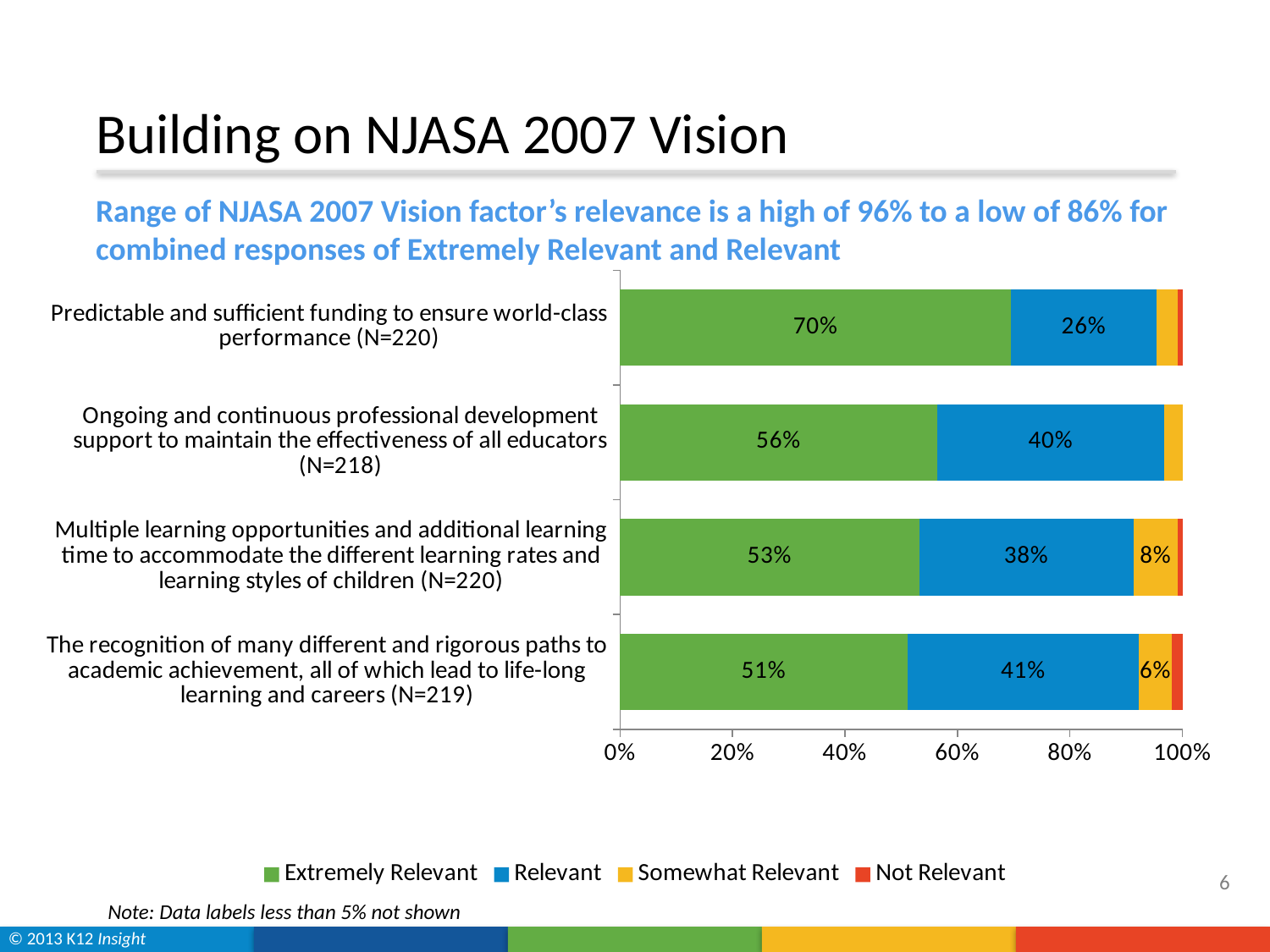
How many series does the legend list? 4 How many factors (categories) are shown in the chart? 4 For "Multiple learning opportunities and additional learning time", which is larger: the Extremely Relevant share or the Relevant share? Extremely Relevant What percentage of respondents rated "Predictable and sufficient funding to ensure world-class performance" as Extremely Relevant? 70% What is the Somewhat Relevant percentage for "Multiple learning opportunities and additional learning time to accommodate the different learning rates and learning styles of children"? 8% What is the combined Extremely Relevant and Relevant percentage for "Predictable and sufficient funding to ensure world-class performance"? 96% Which factor has the lowest Relevant percentage? Predictable and sufficient funding to ensure world-class performance What is the difference between the Extremely Relevant percentages for "Predictable and sufficient funding" and "Ongoing and continuous professional development support"? 14 percentage points What is the Somewhat Relevant percentage for "The recognition of many different and rigorous paths to academic achievement, all of which lead to life-long learning and careers"? 6% Which factor has the highest Extremely Relevant percentage? Predictable and sufficient funding to ensure world-class performance What is the Relevant percentage for "Ongoing and continuous professional development support to maintain the effectiveness of all educators"? 40% Which factor has the lowest Extremely Relevant percentage? The recognition of many different and rigorous paths to academic achievement, all of which lead to life-long learning and careers